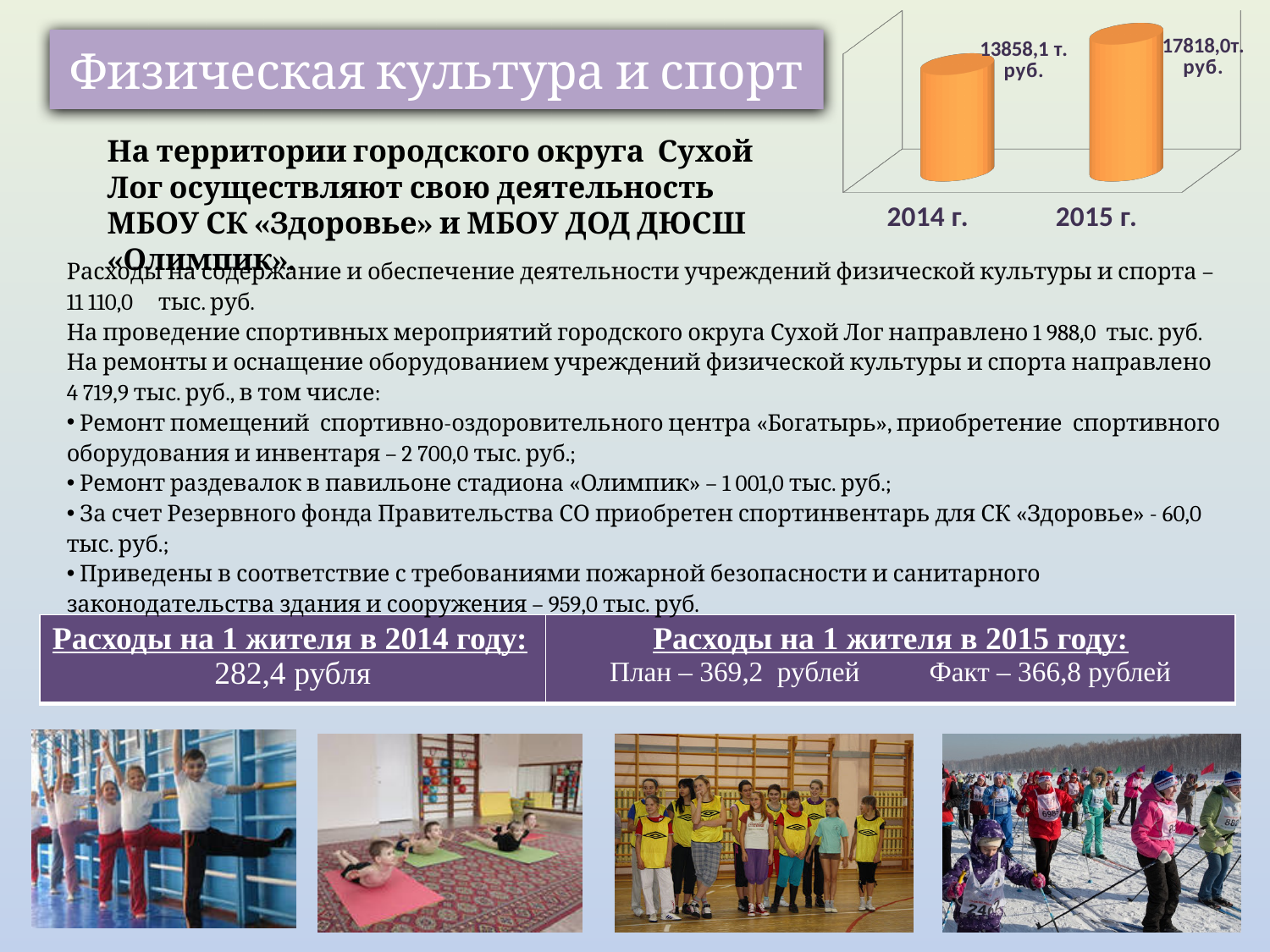
What value does the chart show for 2015 г.? 17818,0т. руб. What colour are the bars in the chart? orange Is the value for 2014 г. larger or smaller than the value for 2015 г.? smaller What value does the chart show for 2014 г.? 13858,1 т. руб. What kind of chart is shown in the top right of the slide? bar chart Which year has the lower value in the chart? 2014 г. What are the category labels on the x axis of the chart? 2014 г. and 2015 г. Do the values in the chart rise or fall from 2014 г. to 2015 г.? rise Which year has the higher value in the chart? 2015 г. How many categories (years) are shown in the chart? 2 By how much does the 2015 г. value exceed the 2014 г. value in the chart? 3959,9 т. руб.